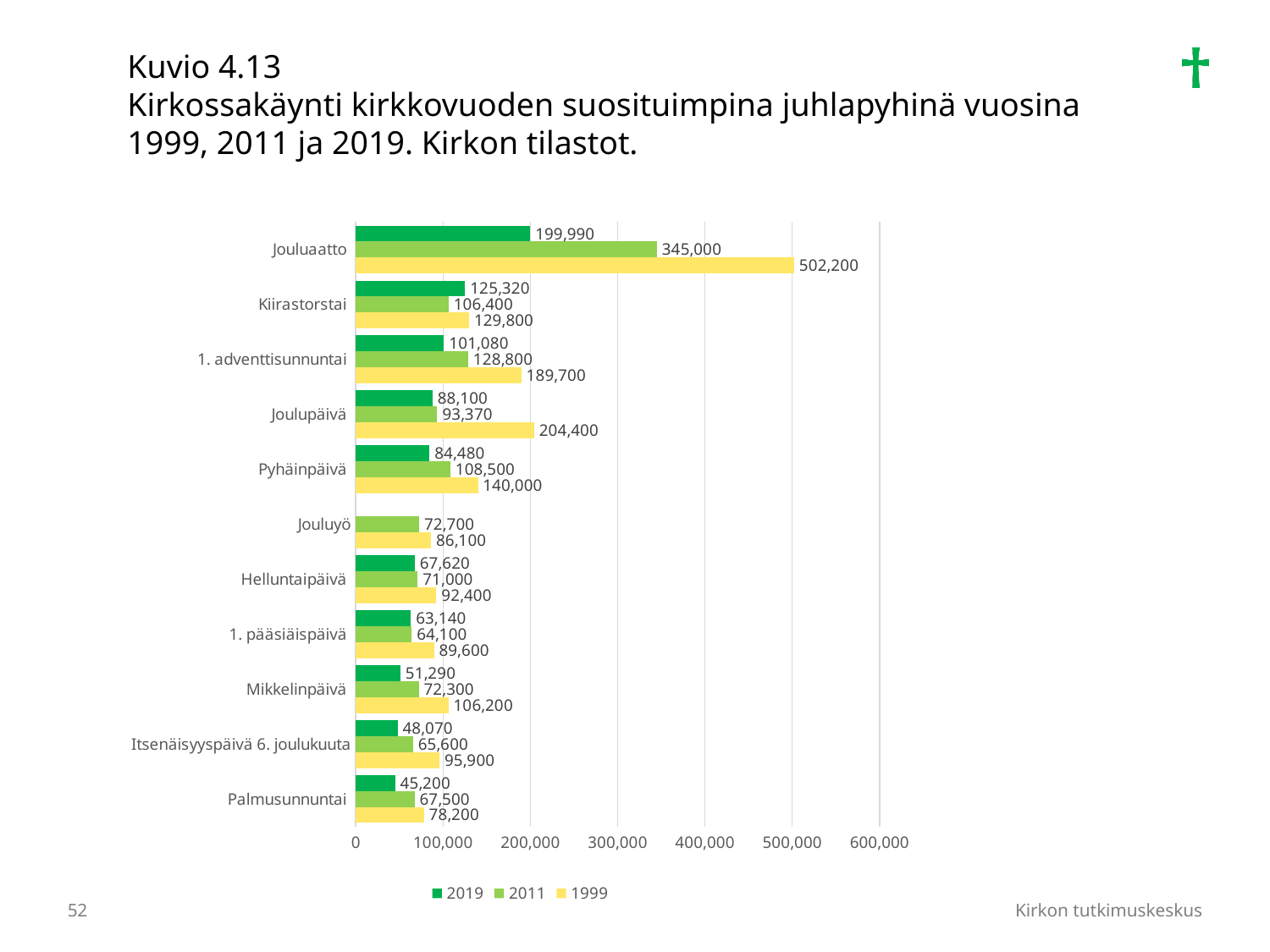
Which is larger for Kiirastorstai: the 2019 value or the 2011 value? 2019 Which series is shown in yellow in the legend? 1999 What is the 1999 value for Jouluaatto? 502,200 What is the 2019 value for Kiirastorstai? 125,320 How many series does the legend list? 3 What kind of chart is shown on the slide? Bar chart Which holiday has the highest 2011 value? Jouluaatto What is the difference between the 1999 and 2019 values for Jouluaatto? 302,210 What is the difference between the 1999 and 2011 values for Joulupäivä? 111,030 How many categories (holidays) are shown on the chart? 11 What is the 2011 value for Mikkelinpäivä? 72,300 Which holiday has the lowest 2019 value? Palmusunnuntai